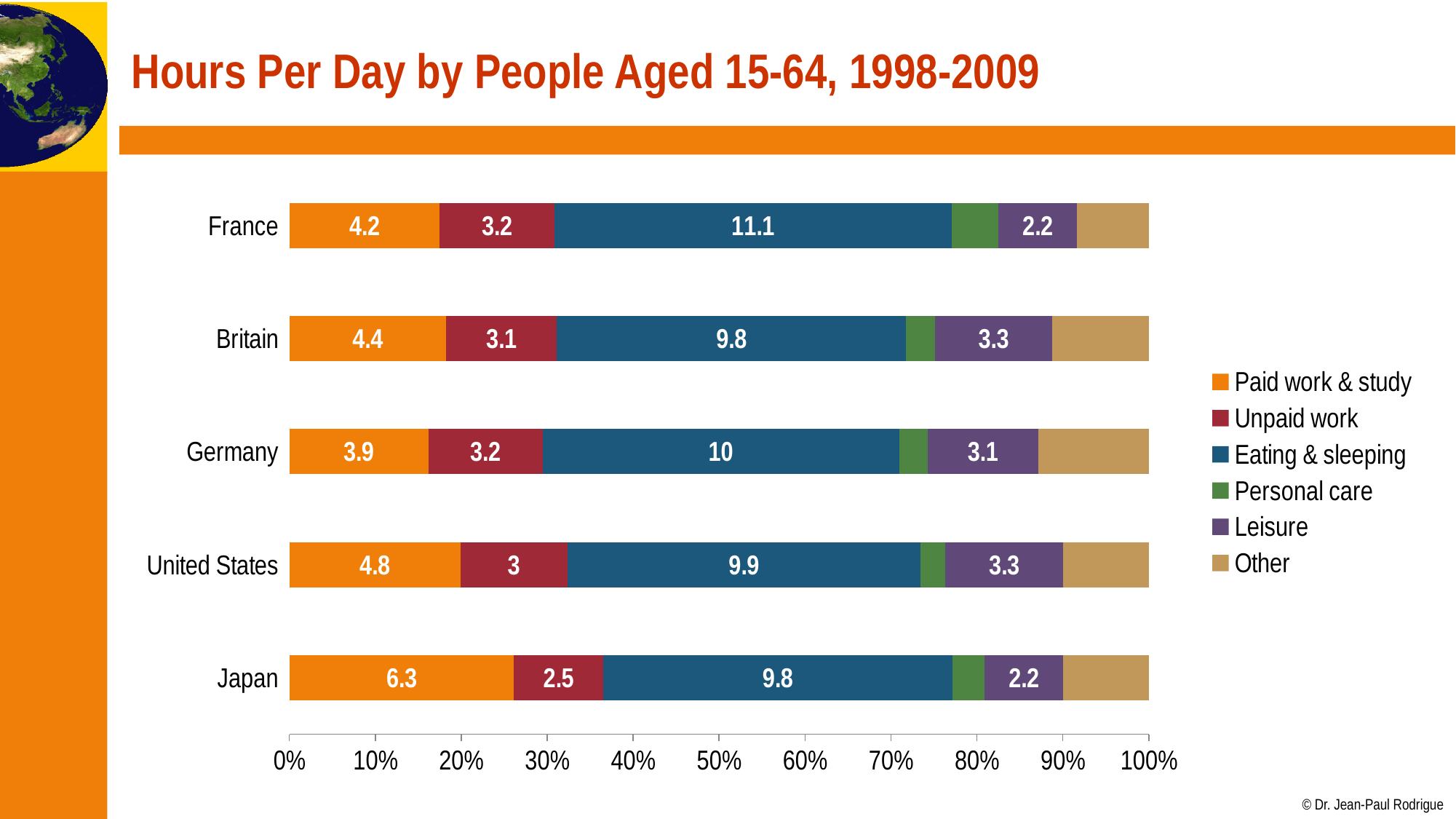
How many countries are shown on the chart? 5 What is the value for Eating & sleeping for France? 11.1 How many series does the legend list? 6 What is the value for Unpaid work for the United States? 3 Which country has the lowest value for Unpaid work? Japan Which series is shown in green in the legend? Personal care What kind of chart is shown on the slide? Stacked bar chart What is the value for Paid work & study for Japan? 6.3 What is the value for Leisure for Germany? 3.1 What is the difference between the Paid work & study values for Japan and Germany? 2.4 Which is larger, the Eating & sleeping value for France or for Germany? France Which country has the highest value for Paid work & study? Japan